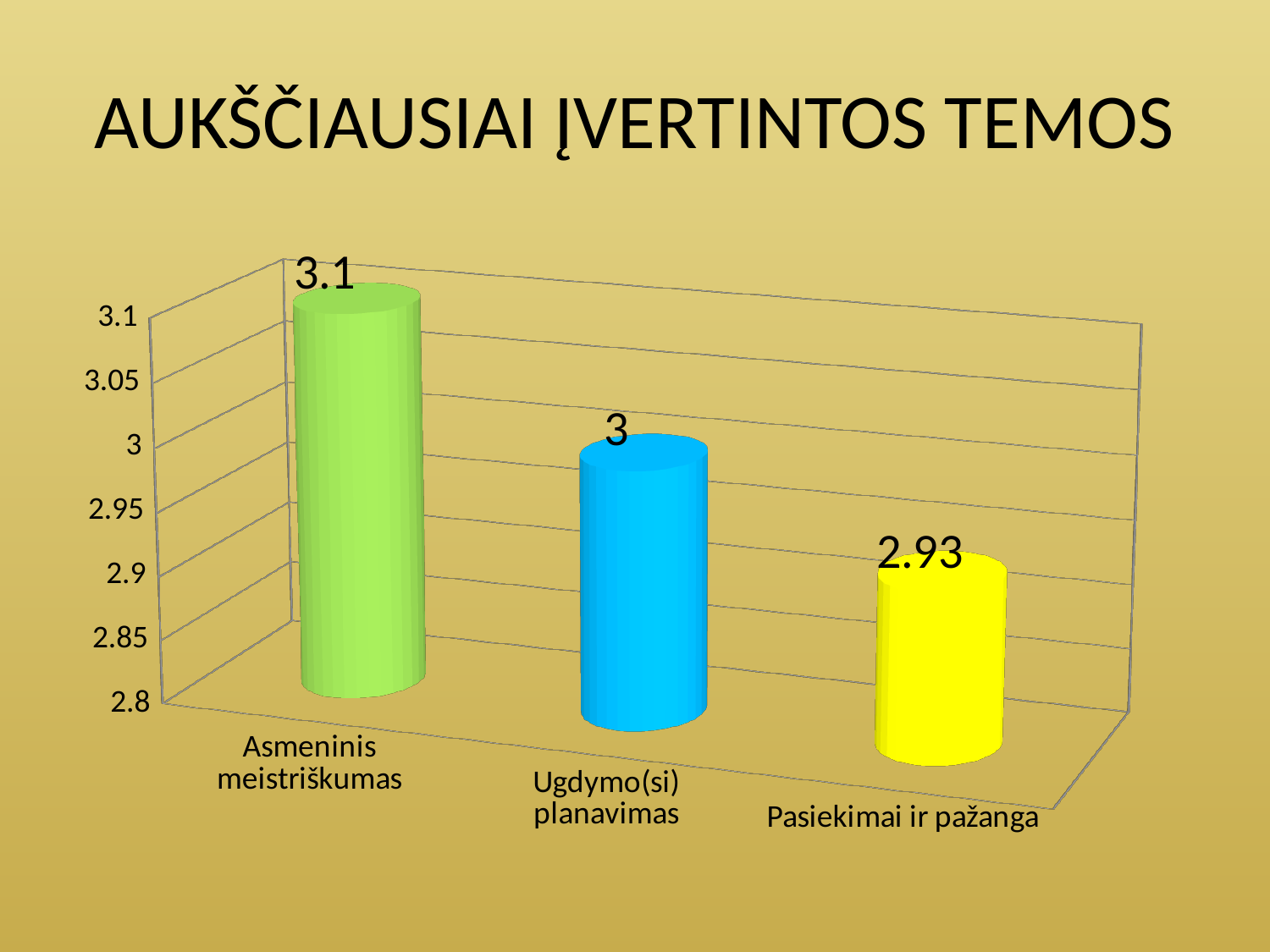
Which category has the highest value? Asmeninis meistriškumas What is the difference between the values for Ugdymo(si) planavimas and Pasiekimai ir pažanga? 0.07 Is the value for Pasiekimai ir pažanga greater or less than 3? less What is the value for Asmeninis meistriškumas? 3.1 How many categories are shown in the chart? 3 Do the values rise or fall from left to right across the categories? fall What kind of chart is shown on the slide? bar chart Which is larger, the value for Ugdymo(si) planavimas or the value for Pasiekimai ir pažanga? Ugdymo(si) planavimas What is the value for Pasiekimai ir pažanga? 2.93 What is the value for Ugdymo(si) planavimas? 3 Which category has the lowest value? Pasiekimai ir pažanga What is the difference between the values for Asmeninis meistriškumas and Pasiekimai ir pažanga? 0.17